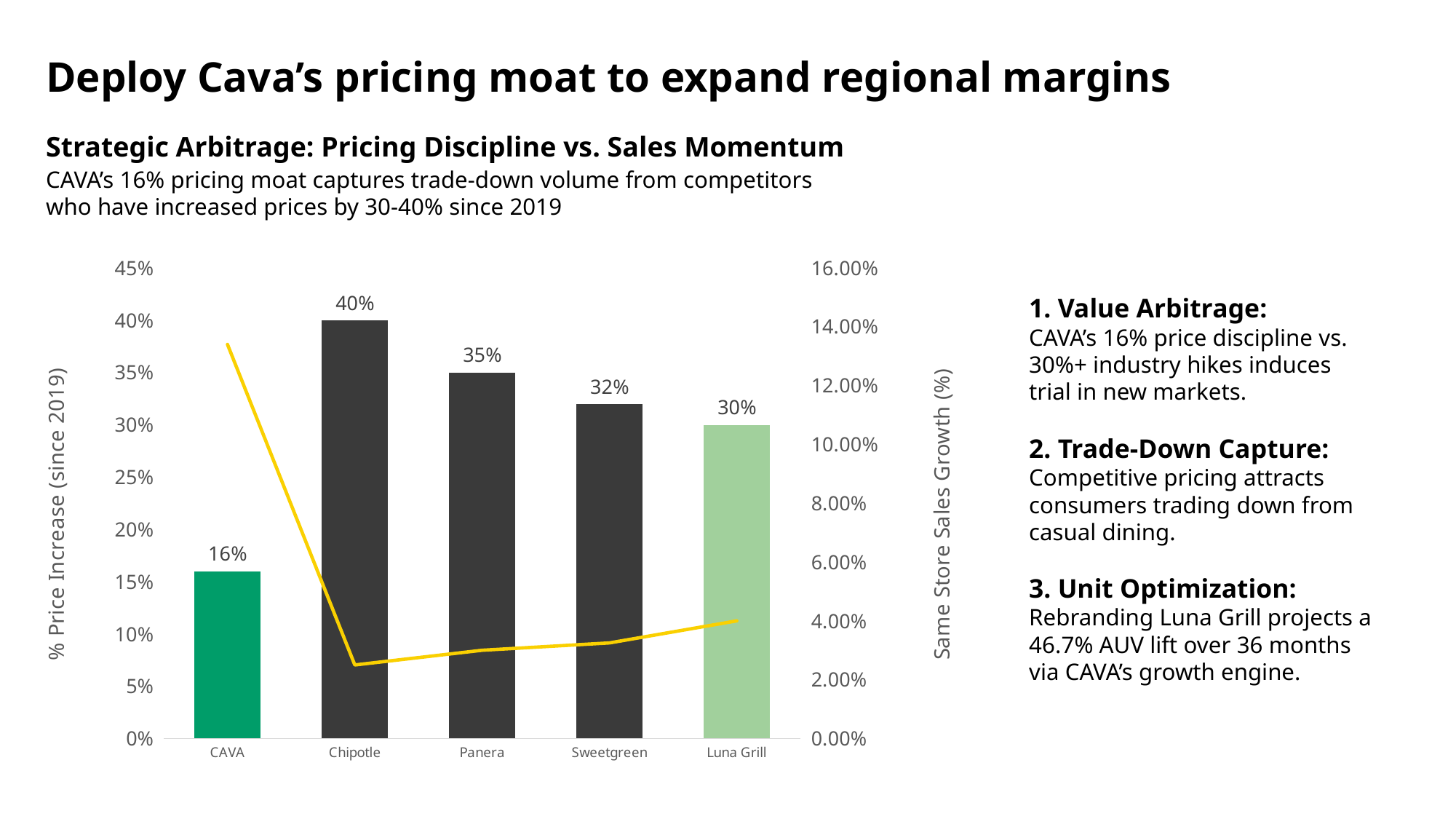
What is the difference in % price increase between Panera and Sweetgreen? 3% How many companies are shown on the x axis of the chart? 5 Is the same store sales growth value for Chipotle on the line greater or less than 4.00%? less What is the % price increase since 2019 shown for Chipotle? 40% What is the % price increase since 2019 shown for CAVA? 16% What is the % price increase since 2019 shown for Luna Grill? 30% Which company has the lowest % price increase since 2019? CAVA Which company has the highest % price increase since 2019? Chipotle What is the label of the right-hand vertical axis? Same Store Sales Growth (%) What is the difference in % price increase between Chipotle and CAVA? 24% Which has a larger % price increase since 2019, Panera or Luna Grill? Panera Is the same store sales growth value for CAVA on the line greater or less than 12.00%? greater